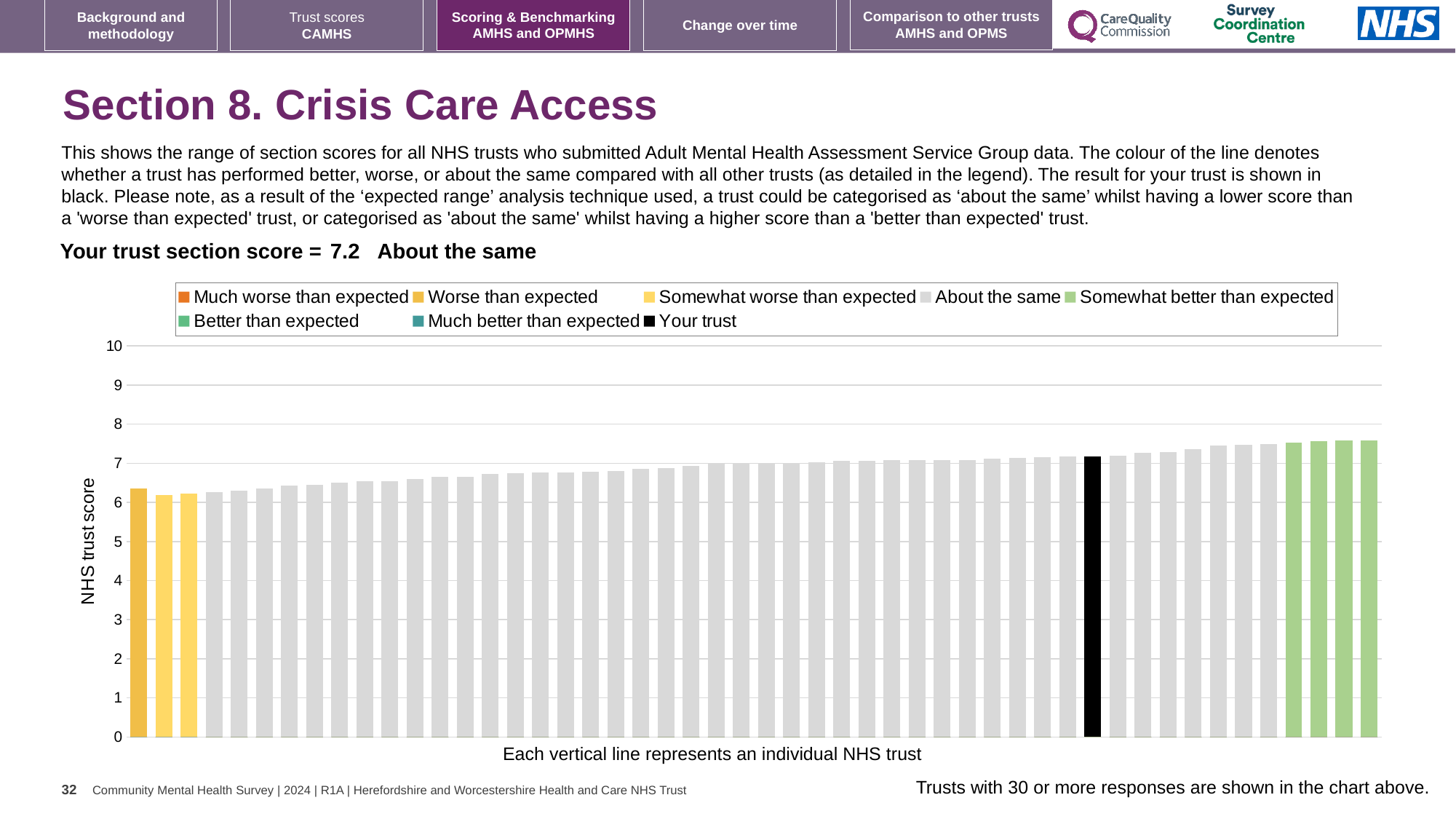
What is the label on the vertical axis of the chart? NHS trust score Which is taller, the leftmost bar or the rightmost bar? the rightmost bar What kind of chart is shown on the slide? bar chart Is the value of the leftmost bar greater or less than 6? greater How many bars are coloured green (somewhat better than expected) in the chart? 4 Is the value of the rightmost bar greater or less than 8? less How many entries does the chart legend list? 8 Do the bar values rise or fall from left to right across the chart? rise Which performance category is your trust placed in for Crisis Care Access? About the same Is the value of the black 'Your trust' bar greater or less than 7? greater What is the highest tick value shown on the vertical axis? 10 What is the section score for your trust shown on the slide? 7.2